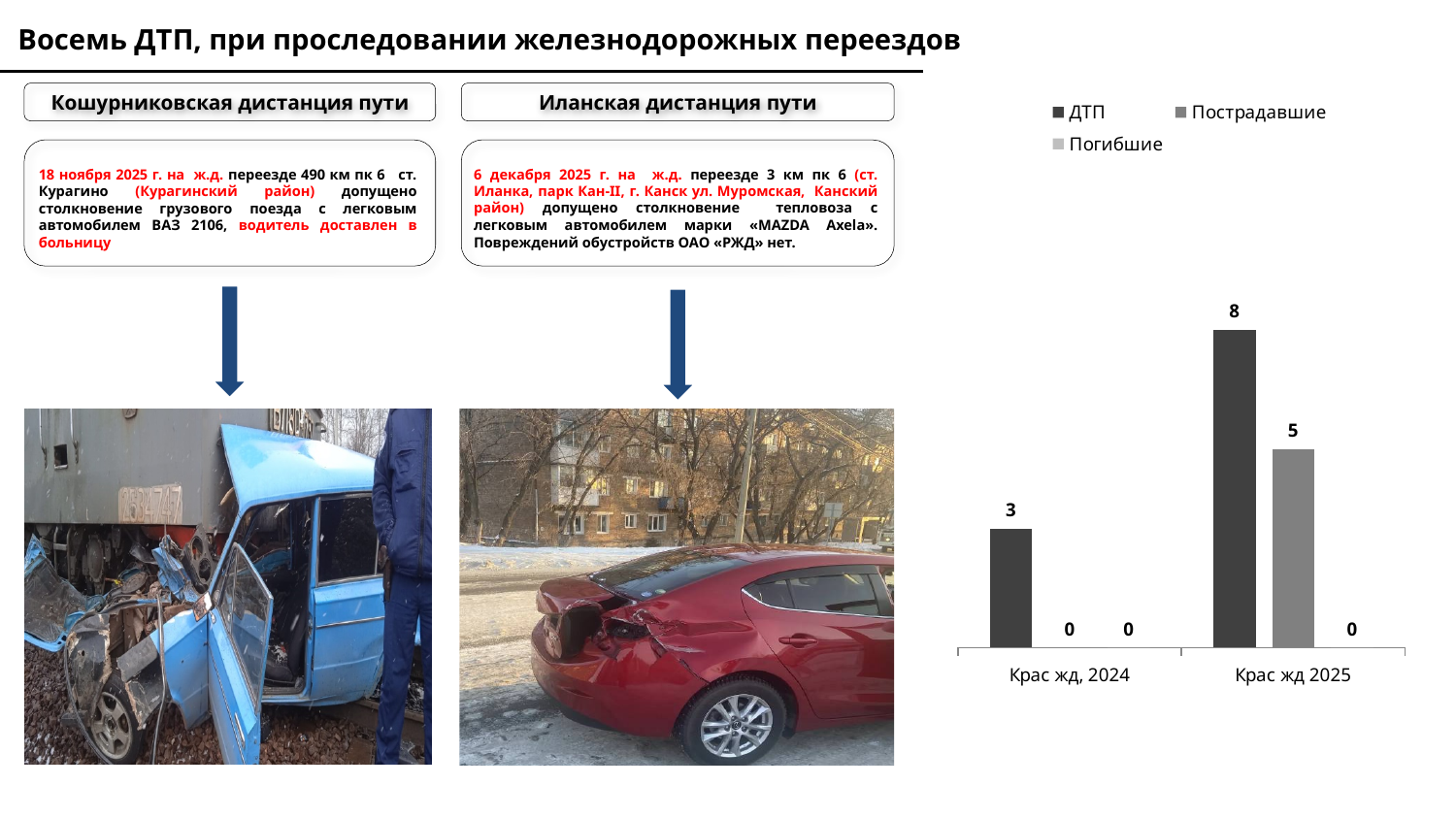
What is the difference in ДТП between Крас жд 2025 and Крас жд, 2024? 5 How many series does the legend list? 3 What is the value of ДТП for Крас жд 2025? 8 What is the value of Пострадавшие for Крас жд 2025? 5 Which category has the higher ДТП value? Крас жд 2025 What is the value of Погибшие for Крас жд 2025? 0 What is the value of ДТП for Крас жд, 2024? 3 Which is larger for Крас жд 2025: ДТП or Пострадавшие? ДТП How many categories are shown on the x axis? 2 What is the difference between ДТП and Пострадавшие for Крас жд 2025? 3 What kind of chart is shown on the slide? Bar chart What is the value of Пострадавшие for Крас жд, 2024? 0